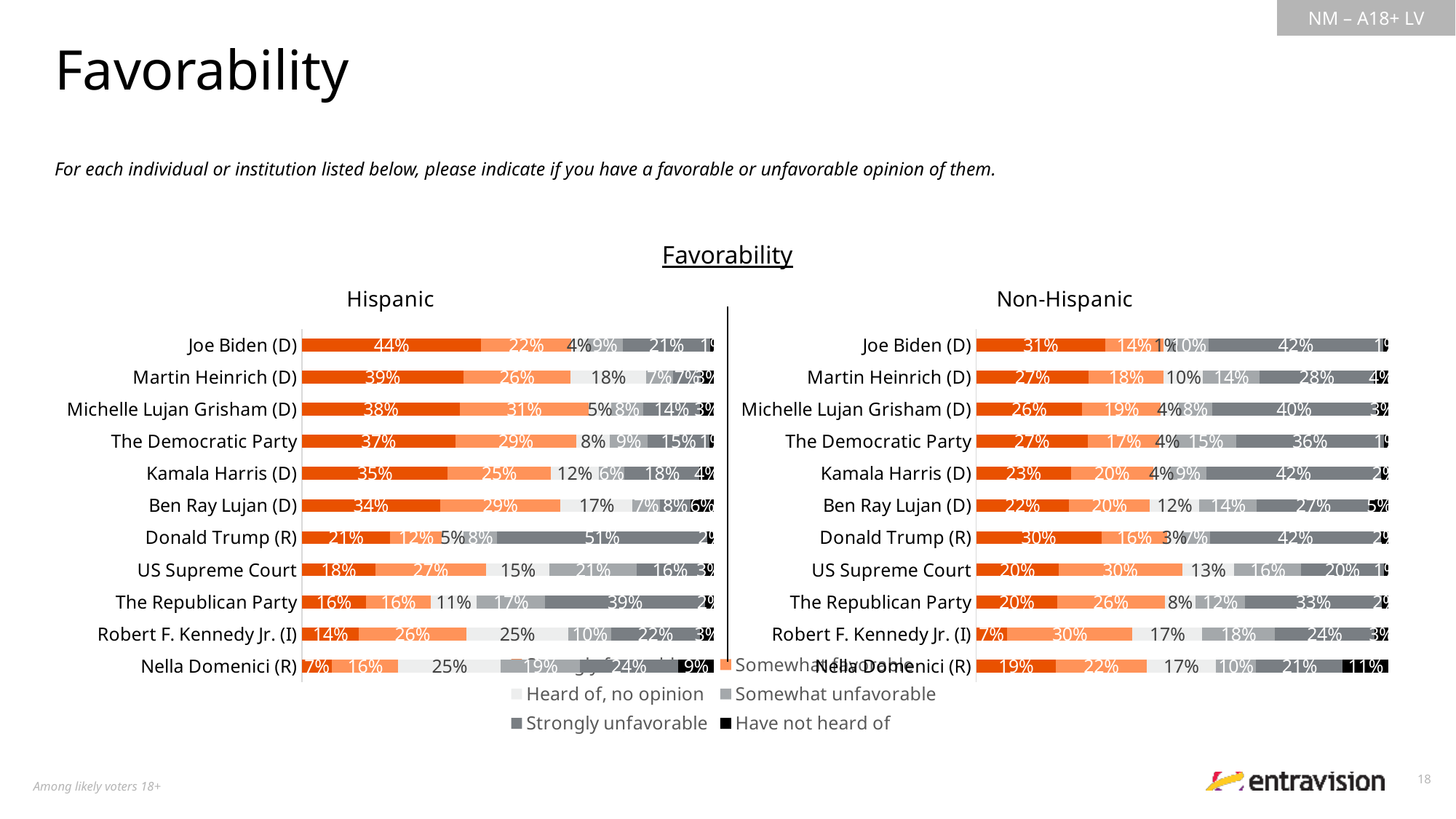
What kind of chart is used for the Hispanic favorability data? Stacked bar chart In the Non-Hispanic chart, whose leftmost dark orange segment is larger, Donald Trump (R) or Kamala Harris (D)? Donald Trump (R) In the Non-Hispanic chart, what is the 'Have not heard of' (black) value for Nella Domenici (R)? 11% How many series does the legend list for the favorability charts? 6 In the Hispanic chart, what is the strongly unfavorable (dark gray) value for Donald Trump (R)? 51% What is the difference between Joe Biden (D)'s leftmost dark orange segment in the Hispanic chart (44%) and in the Non-Hispanic chart (31%)? 13 percentage points In the Hispanic chart, which individual or institution has the smallest leftmost dark orange segment? Nella Domenici (R) What are the two groups compared by the two charts on the slide? Hispanic and Non-Hispanic In the Hispanic chart, which individual or institution has the largest leftmost dark orange segment? Joe Biden (D) How many individuals or institutions are listed in the Hispanic chart? 11 In the Non-Hispanic chart, what is the value of the leftmost dark orange segment for Joe Biden (D)? 31% In the Hispanic chart, what is the somewhat favorable (light orange) value for the US Supreme Court? 27%